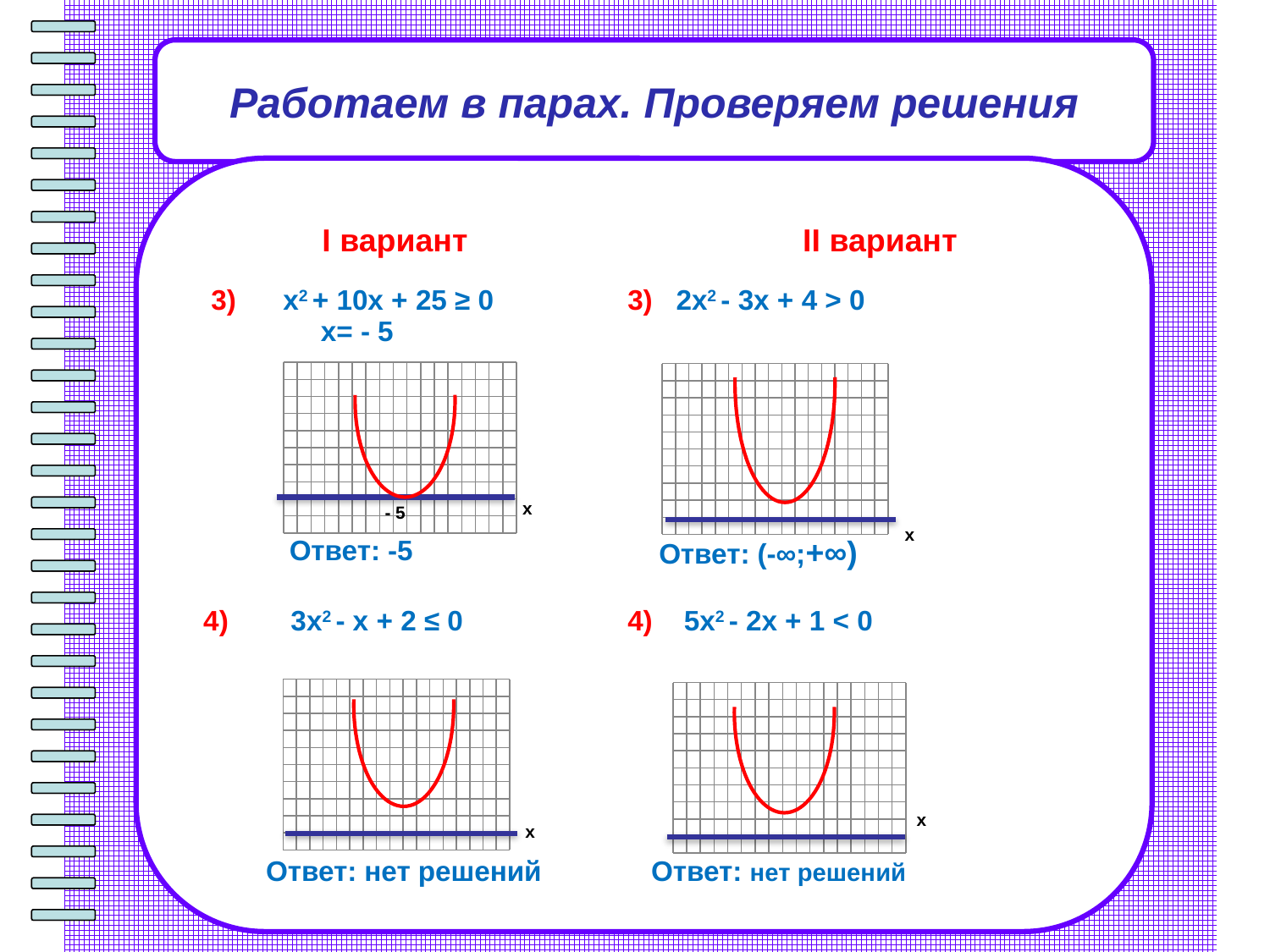
How many parabola graphs are shown on the slide? 4 Which of the four graphs has its parabola touching the x axis? the top-left graph On the top-left graph, does the parabola open upward or downward? upward On the top-left graph (for x² + 10x + 25 ≥ 0), what x value is labelled at the point where the parabola touches the x axis? -5 What colour is the parabola curve drawn in on each graph? red On the top-right graph (for 2x² - 3x + 4 > 0), does the parabola lie above or below the x axis? above